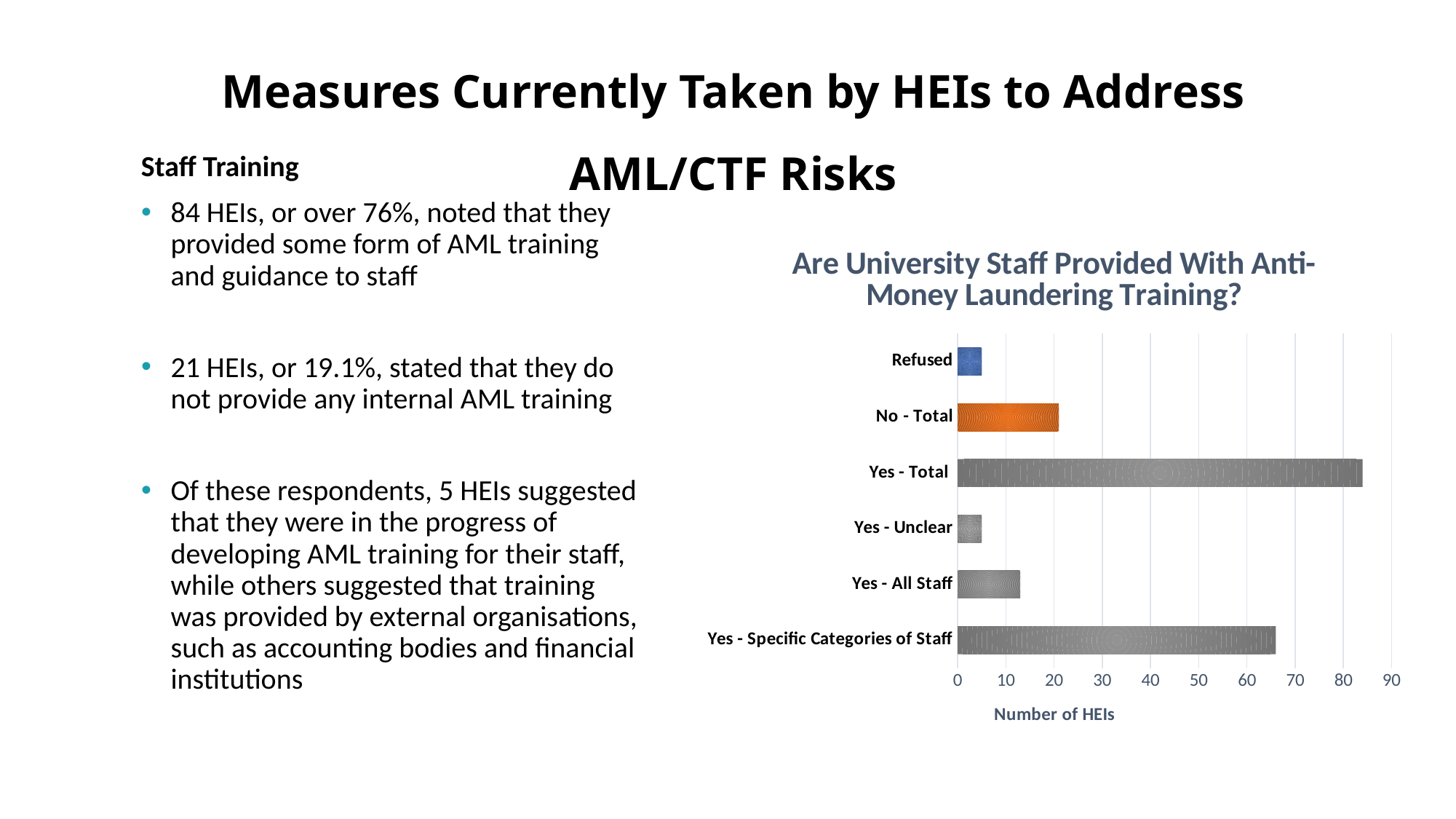
How many categories are plotted in the chart? 6 Is the value for No - Total greater or less than 30? less Is the value for Yes - All Staff greater or less than 20? less Is the value for Refused greater or less than 10? less What is the title of the chart? Are University Staff Provided With Anti-Money Laundering Training? What is the label of the horizontal axis of the chart? Number of HEIs Which category has the highest number of HEIs? Yes - Total Which is larger, the value for No - Total or the value for Yes - Unclear? No - Total What kind of chart is shown on the slide? bar chart Which is larger, the value for Yes - Specific Categories of Staff or the value for Yes - All Staff? Yes - Specific Categories of Staff